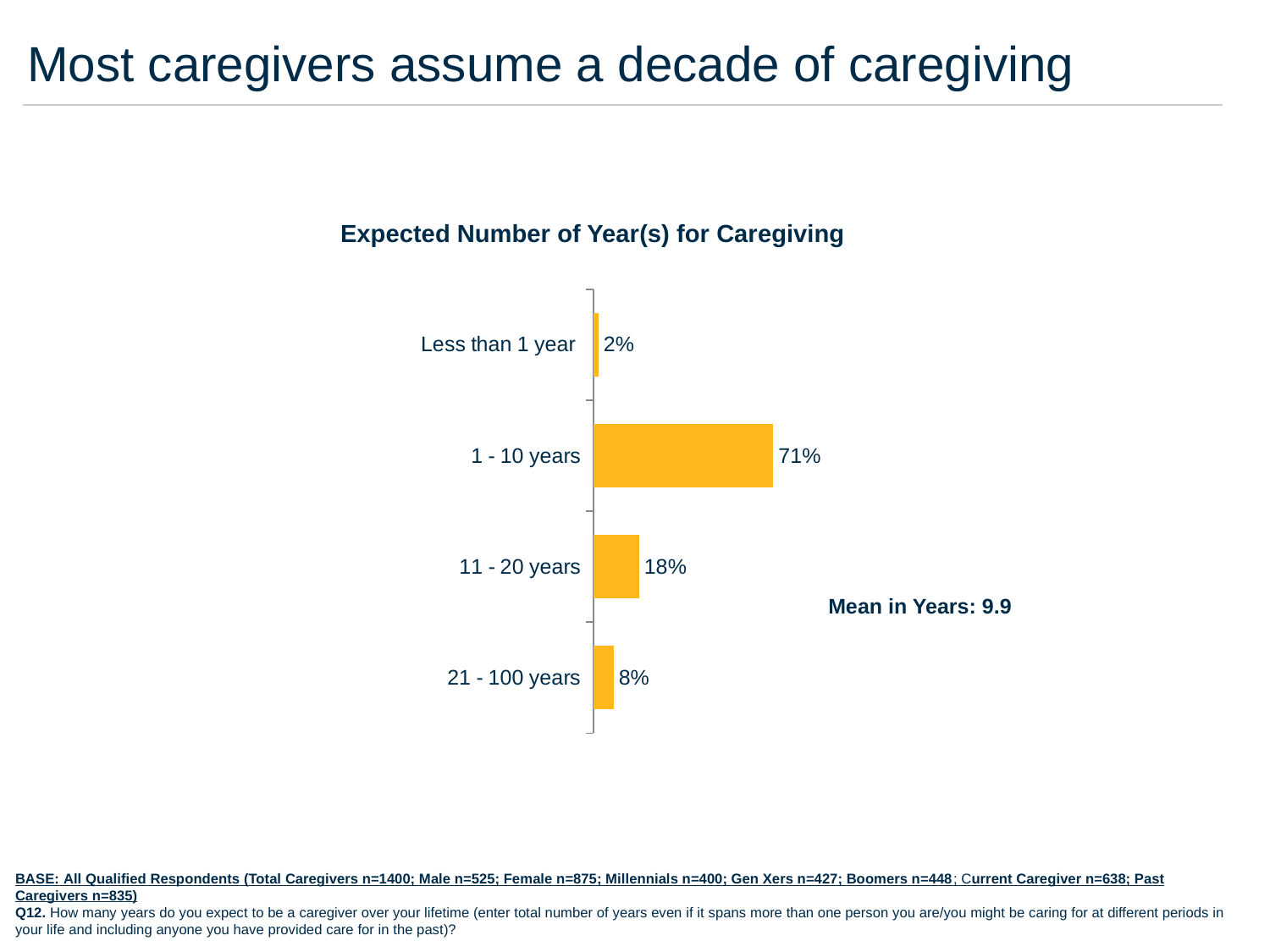
How many categories are shown in the chart? 4 What percentage of caregivers expect 11 - 20 years of caregiving? 18% What kind of chart is shown on the slide? Bar chart What is the mean number of years shown next to the chart? 9.9 What percentage of caregivers expect 21 - 100 years of caregiving? 8% Which is larger, the percentage for 11 - 20 years or for 21 - 100 years? 11 - 20 years What percentage of caregivers expect 1 - 10 years of caregiving? 71% Which category has the highest percentage? 1 - 10 years What is the title of the chart? Expected Number of Year(s) for Caregiving What is the difference in percentage points between the 1 - 10 years and 11 - 20 years categories? 53 What percentage of caregivers expect less than 1 year of caregiving? 2% Which category has the lowest percentage? Less than 1 year